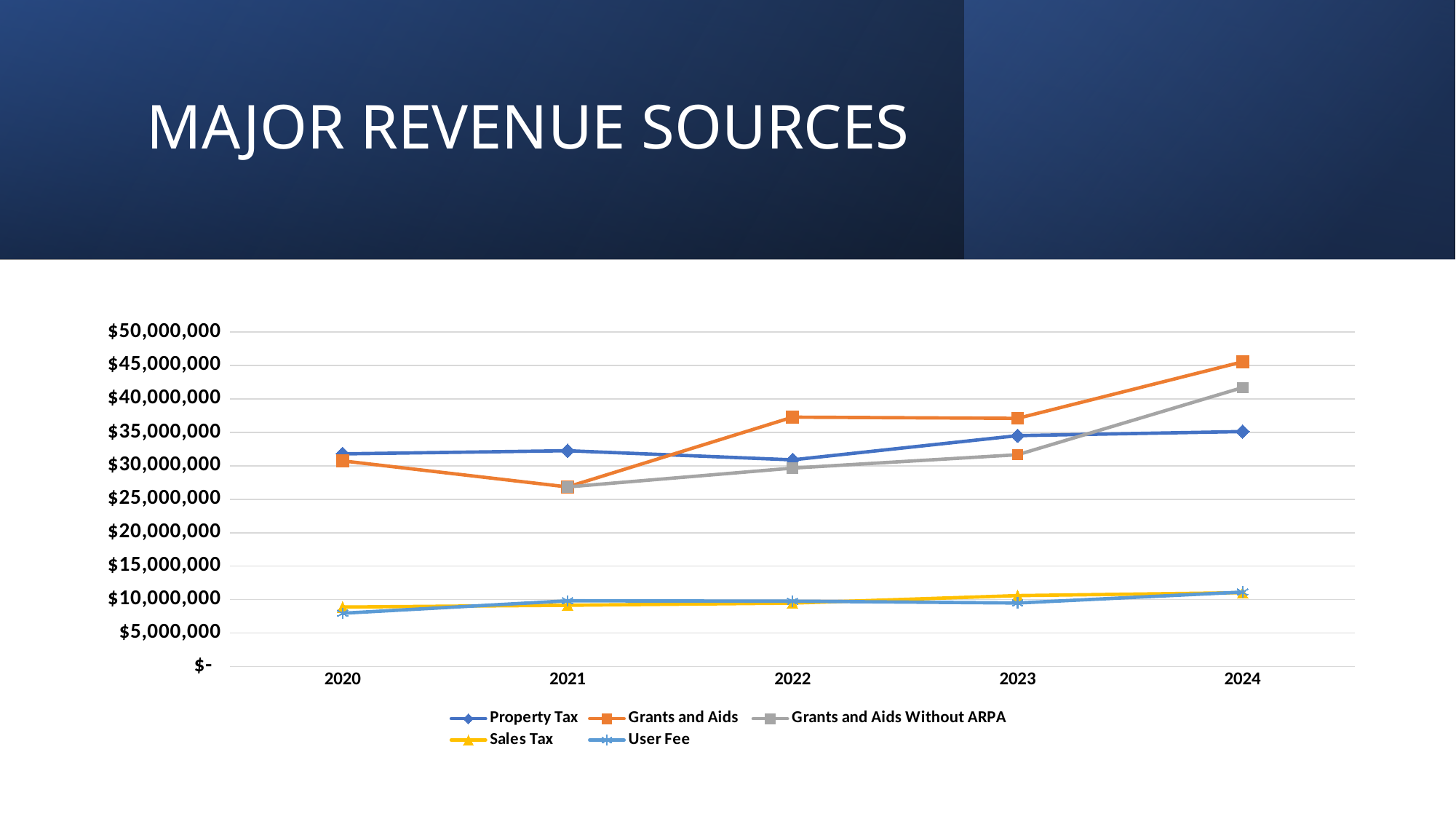
In 2022, which is larger: Property Tax or Grants and Aids? Grants and Aids Is the value for Property Tax in 2024 greater or less than $40,000,000? less Which series has the highest value in 2024? Grants and Aids How many series does the legend list? 5 What kind of chart is shown on the slide? line chart How many years are shown on the x axis? 5 Is the value for Grants and Aids in 2024 greater or less than $40,000,000? greater Does the Grants and Aids Without ARPA series rise or fall from 2021 to 2024? rise What is the title of the slide containing the chart? MAJOR REVENUE SOURCES Which series has the lowest value in 2020? User Fee Is the value for Grants and Aids in 2021 greater or less than $30,000,000? less In 2023, which is larger: Property Tax or Grants and Aids Without ARPA? Property Tax